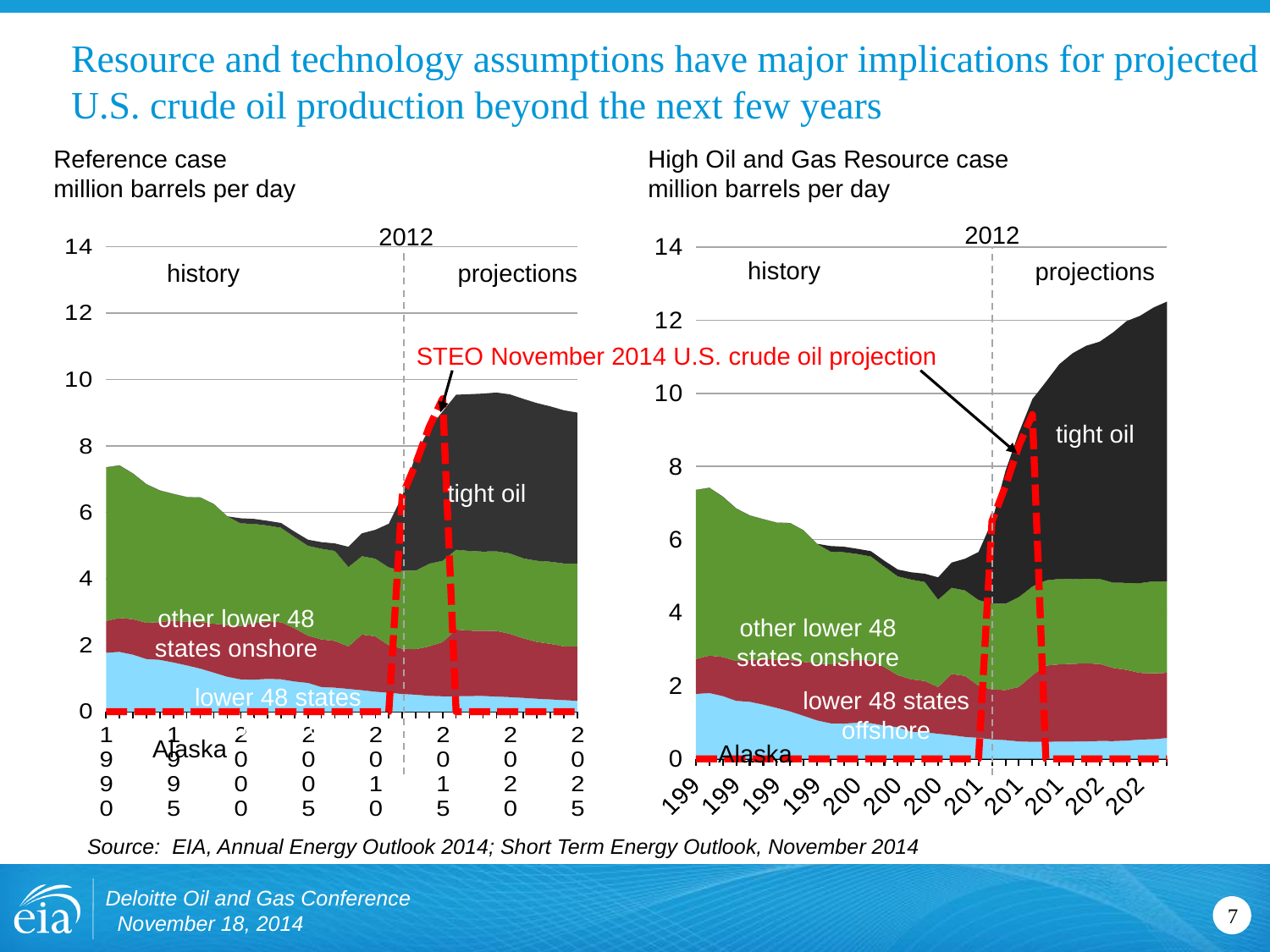
How many production categories are stacked in the Reference case chart? 4 In the Reference case chart, is the total crude oil production in 2025 greater or less than 8? greater In the Reference case chart, does total crude oil production rise or fall between 1990 and 2005? fall What kind of chart is the Reference case chart? area chart In the High Oil and Gas Resource case chart, is the total crude oil production in 2005 greater or less than 6? less Which year does the vertical dashed line separating history from projections mark on both charts? 2012 Which chart shows the higher total crude oil production in 2025, the Reference case or the High Oil and Gas Resource case? High Oil and Gas Resource case In what unit are the values on both charts expressed? million barrels per day In the High Oil and Gas Resource case chart, is the total crude oil production in 2025 greater or less than 10? greater In the High Oil and Gas Resource case chart, does total crude oil production rise or fall between 2012 and 2025? rise How many year labels are shown on the x axis of the Reference case chart? 8